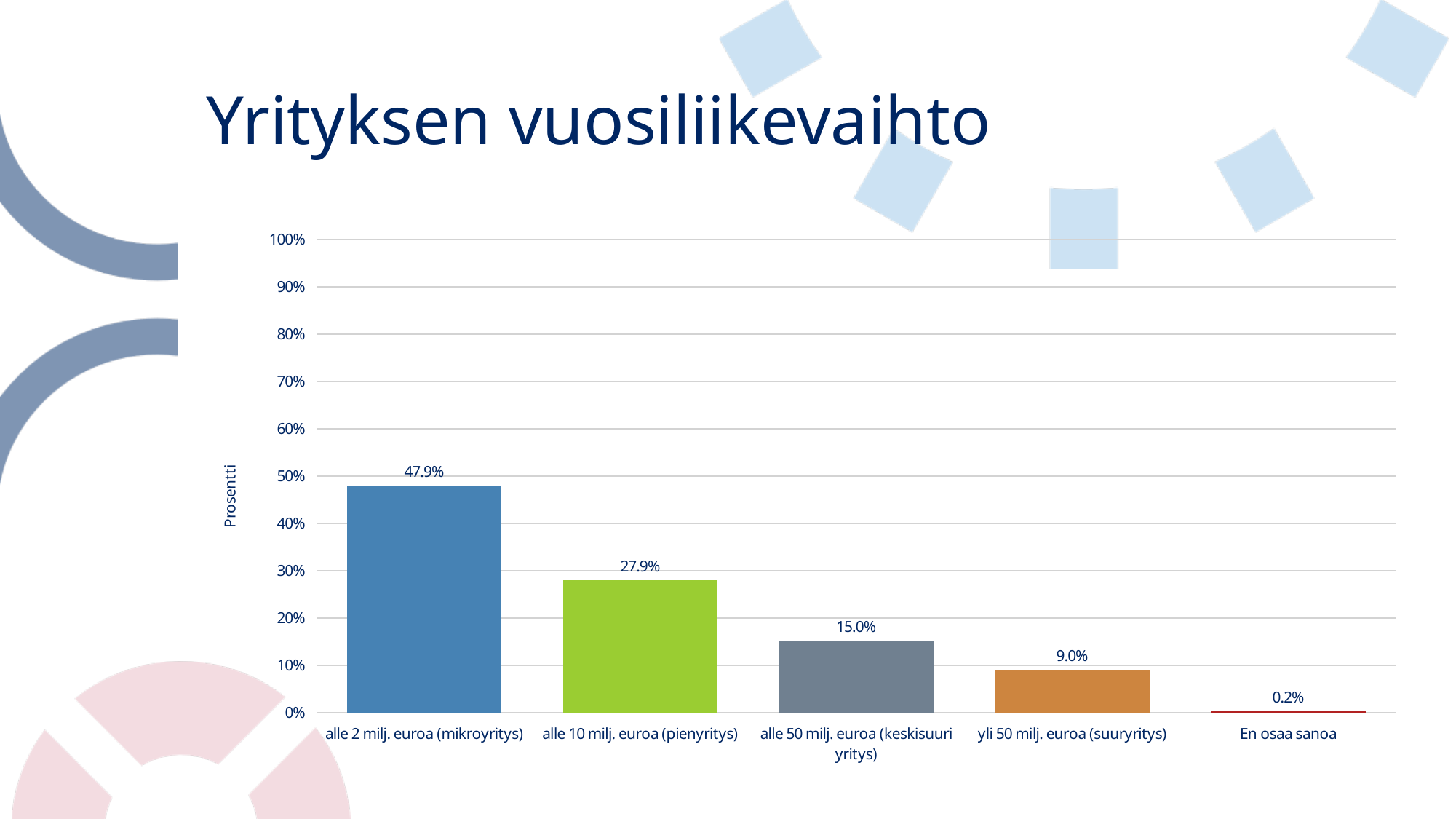
What is the title of the slide? Yrityksen vuosiliikevaihto What is the value for 'yli 50 milj. euroa (suuryritys)'? 9.0% What kind of chart is shown on the slide? bar chart What is the value for 'En osaa sanoa'? 0.2% What is the value for 'alle 10 milj. euroa (pienyritys)'? 27.9% What is the difference between the values for 'alle 2 milj. euroa (mikroyritys)' and 'alle 10 milj. euroa (pienyritys)'? 20.0% Which category has the lowest value? En osaa sanoa Which is larger: the value for 'alle 50 milj. euroa (keskisuuri yritys)' or 'yli 50 milj. euroa (suuryritys)'? alle 50 milj. euroa (keskisuuri yritys) Which category has the highest value? alle 2 milj. euroa (mikroyritys) How many categories are shown on the x axis? 5 What is the value for 'alle 2 milj. euroa (mikroyritys)'? 47.9% Is the value for 'alle 10 milj. euroa (pienyritys)' greater or less than 30%? less